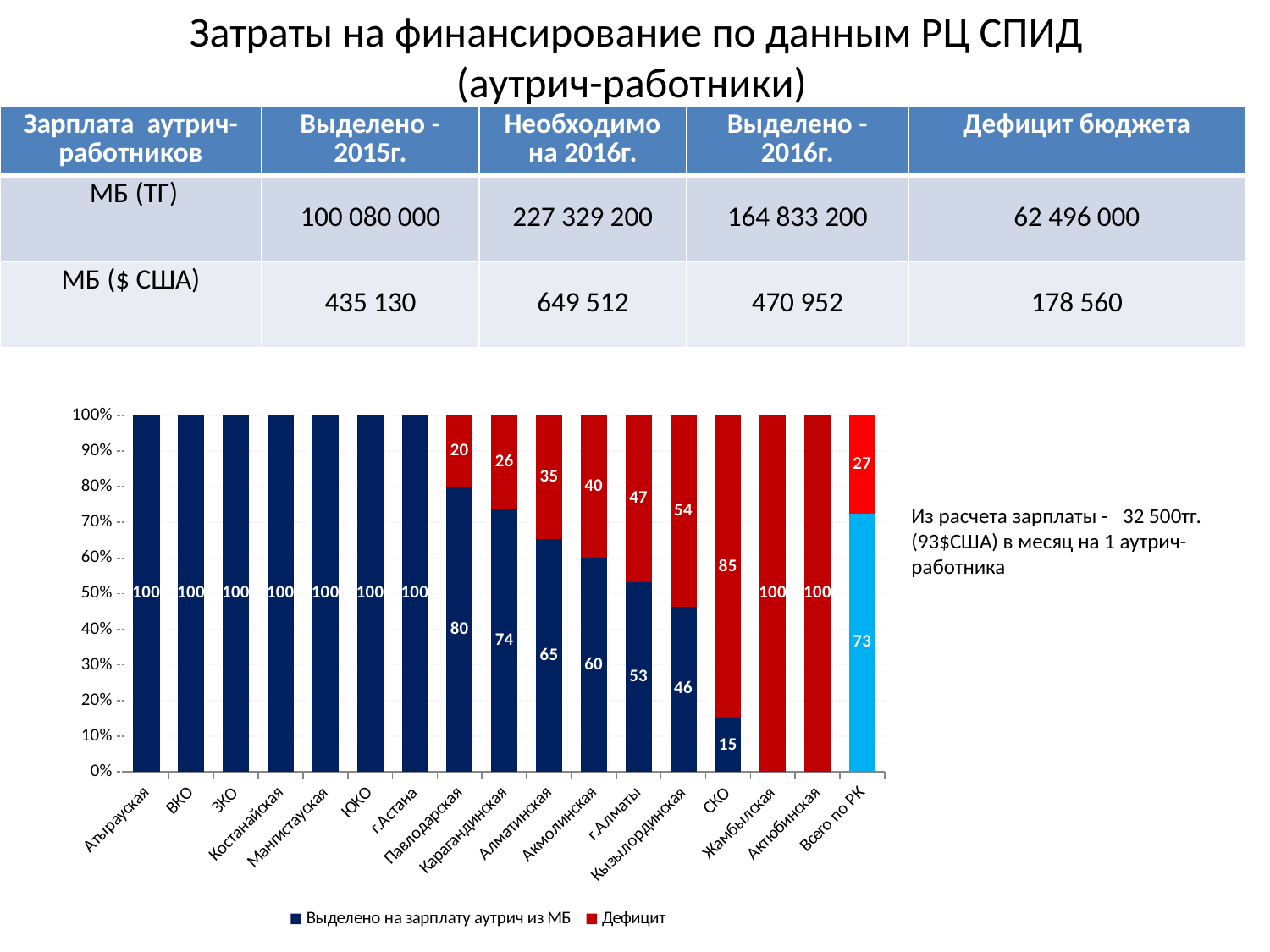
What is the second legend entry of the chart? Дефицит What is the value of 'Дефицит' for СКО? 85 What is the difference between the 'Дефицит' values for г.Алматы and Алматинская? 12 What is the value of 'Дефицит' for Кызылординская? 54 How many categories are shown on the x axis of the chart? 17 Which is larger, the 'Дефицит' value for Акмолинская or for Карагандинская? Акмолинская What is the value of 'Выделено на зарплату аутрич из МБ' for Всего по РК? 73 What is the value of 'Выделено на зарплату аутрич из МБ' for Павлодарская? 80 How many series does the chart legend list? 2 What kind of chart is shown on the slide? stacked bar chart Which category has the lowest non-zero value of 'Выделено на зарплату аутрич из МБ'? СКО What is the total of the stacked bar for Карагандинская? 100